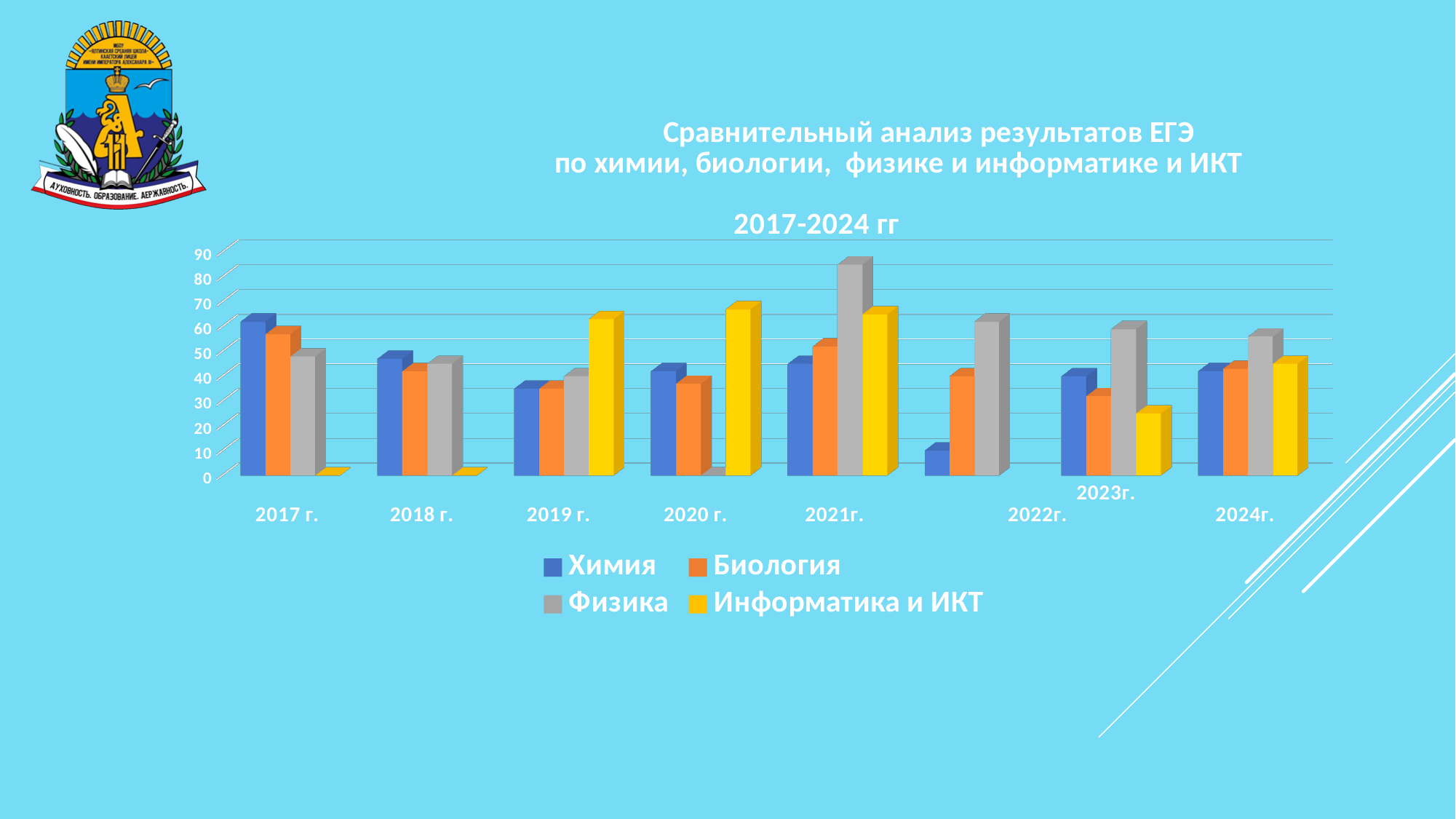
How many series does the legend list? 4 Which series has the tallest bar in the whole chart? Физика Is the value for Биология in 2023г. greater or less than 40? less Which is larger: the value for Химия in 2017 г. or in 2018 г.? 2017 г. Which subject has the lowest value in 2022г.? Химия Which subject has the highest value in 2021г.? Физика Is the value for Химия in 2017 г. greater or less than 50? greater How many year categories are shown on the x axis? 8 What kind of chart is shown on the slide? bar chart Which subject has the highest value in 2019 г.? Информатика и ИКТ Is the value for Физика in 2021г. greater or less than 80? greater Does the value for Физика rise or fall from 2021г. to 2024г.? fall